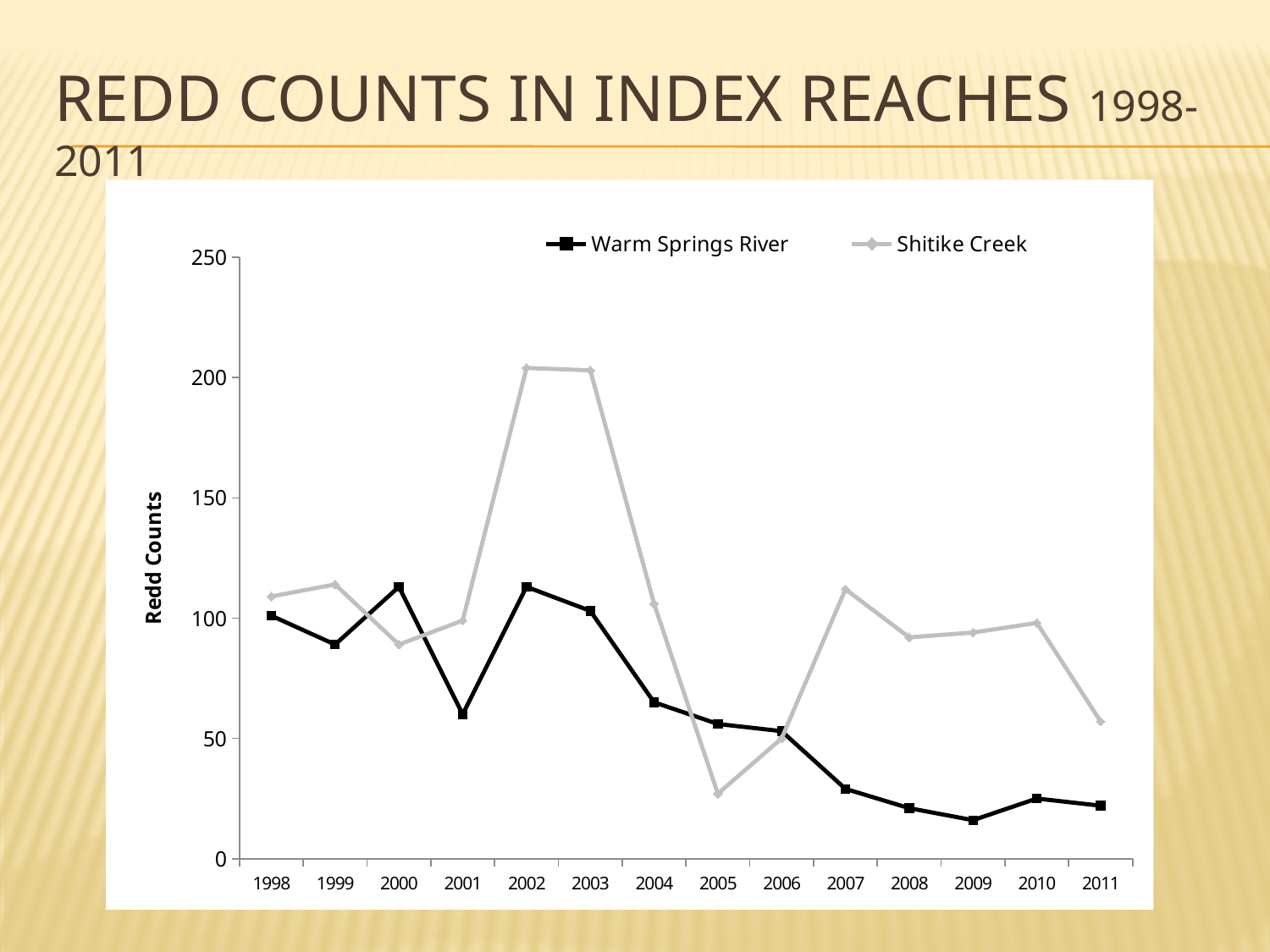
What is the label on the y axis? Redd Counts How many years are plotted along the x axis? 14 In which year is the Warm Springs River redd count lowest? 2009 In which year is the Shitike Creek redd count lowest? 2005 In 2005, which series has the higher redd count, Warm Springs River or Shitike Creek? Warm Springs River Is the Shitike Creek value for 2005 greater or less than 50? less Does the Warm Springs River redd count rise or fall from 2006 to 2009? Fall What kind of chart is shown on the slide? Line chart Is the Shitike Creek value for 2002 greater or less than 150? greater In 2002, which series has the higher redd count, Warm Springs River or Shitike Creek? Shitike Creek Is the Warm Springs River value for 2001 greater or less than 100? less How many series does the legend list? 2